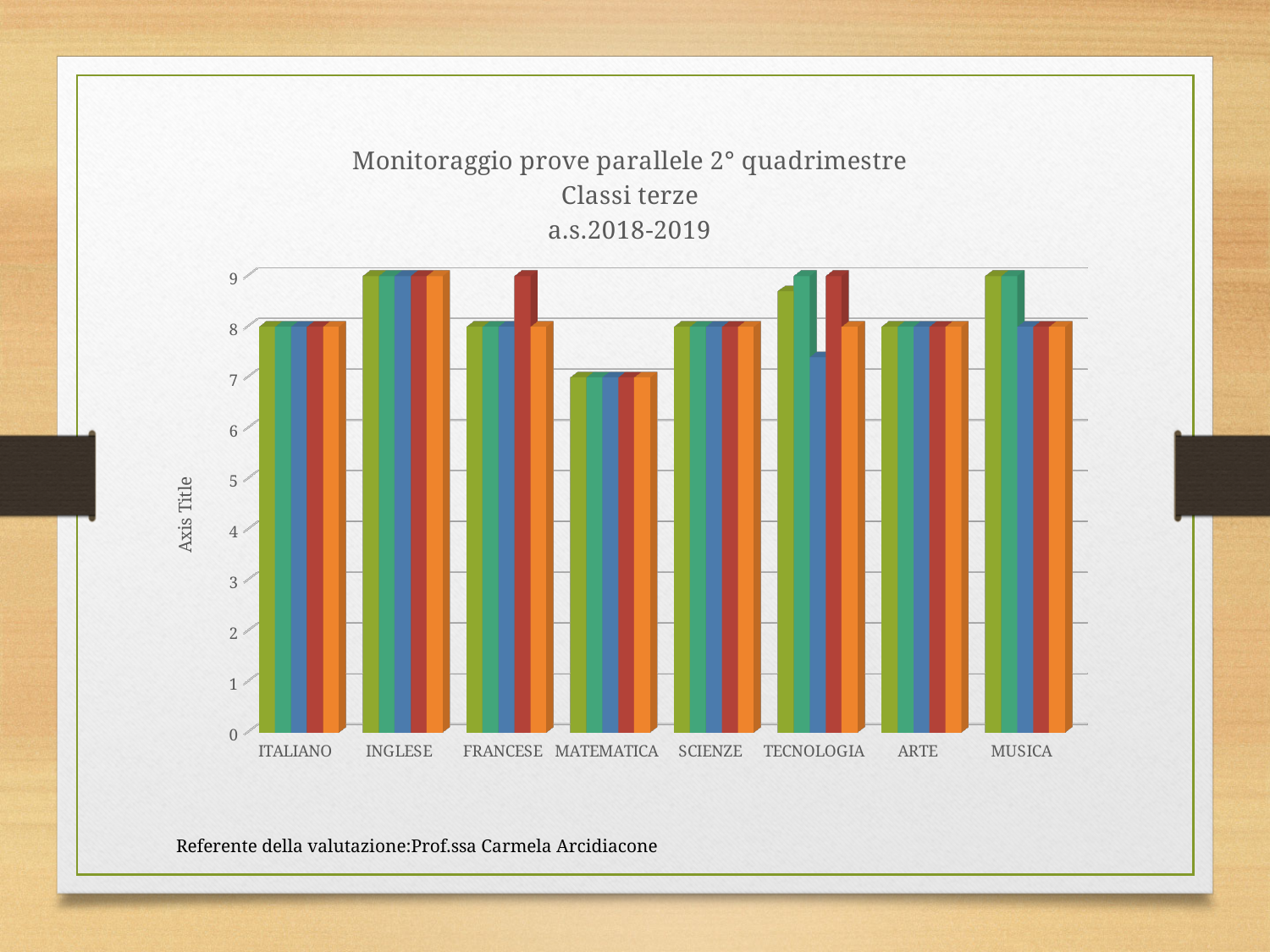
What kind of chart is shown on the slide? bar chart How many subject categories are shown on the x axis? 8 What is the title of the vertical axis? Axis Title Which subject has the lowest values across all its bars? MATEMATICA How many bars are plotted for each subject category? 5 What value do all the bars for MATEMATICA reach? 7 Which subject has all of its bars at the highest value on the chart? INGLESE What is the difference between the value for INGLESE and the value for MATEMATICA? 2 Is the value of the first (leftmost) bar for TECNOLOGIA greater or less than 8? greater What value do all the bars for ARTE reach? 8 What value do all the bars for ITALIANO reach? 8 What value do all the bars for INGLESE reach? 9